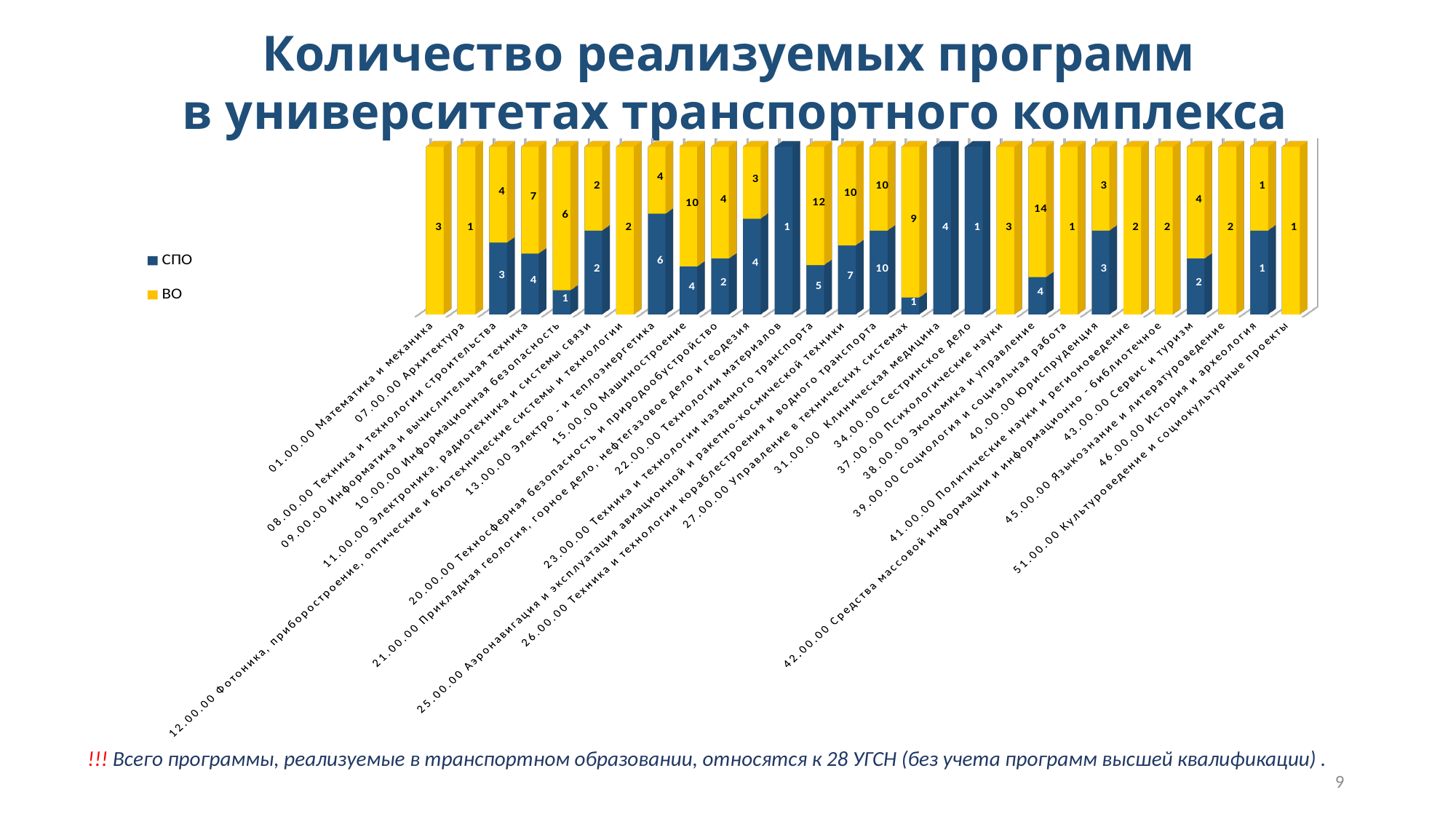
What are the two series named in the legend? СПО and ВО What is the СПО value for 26.00.00 Техника и технологии кораблестроения и водного транспорта? 10 What is the ВО value for 38.00.00 Экономика и управление? 14 Which category has the highest СПО value? 26.00.00 Техника и технологии кораблестроения и водного транспорта How many series does the legend list? 2 Which is larger for 13.00.00 Электро- и теплоэнергетика: the СПО value or the ВО value? СПО What is the difference between the ВО and СПО values for 15.00.00 Машиностроение? 6 What type of chart is shown on the slide? Stacked bar chart How many categories (УГСН) are plotted along the x axis? 28 Which category has the highest ВО value? 38.00.00 Экономика и управление What is the total number of programs (СПО plus ВО) for 23.00.00 Техника и технологии наземного транспорта? 17 What is the ВО value for 23.00.00 Техника и технологии наземного транспорта? 12